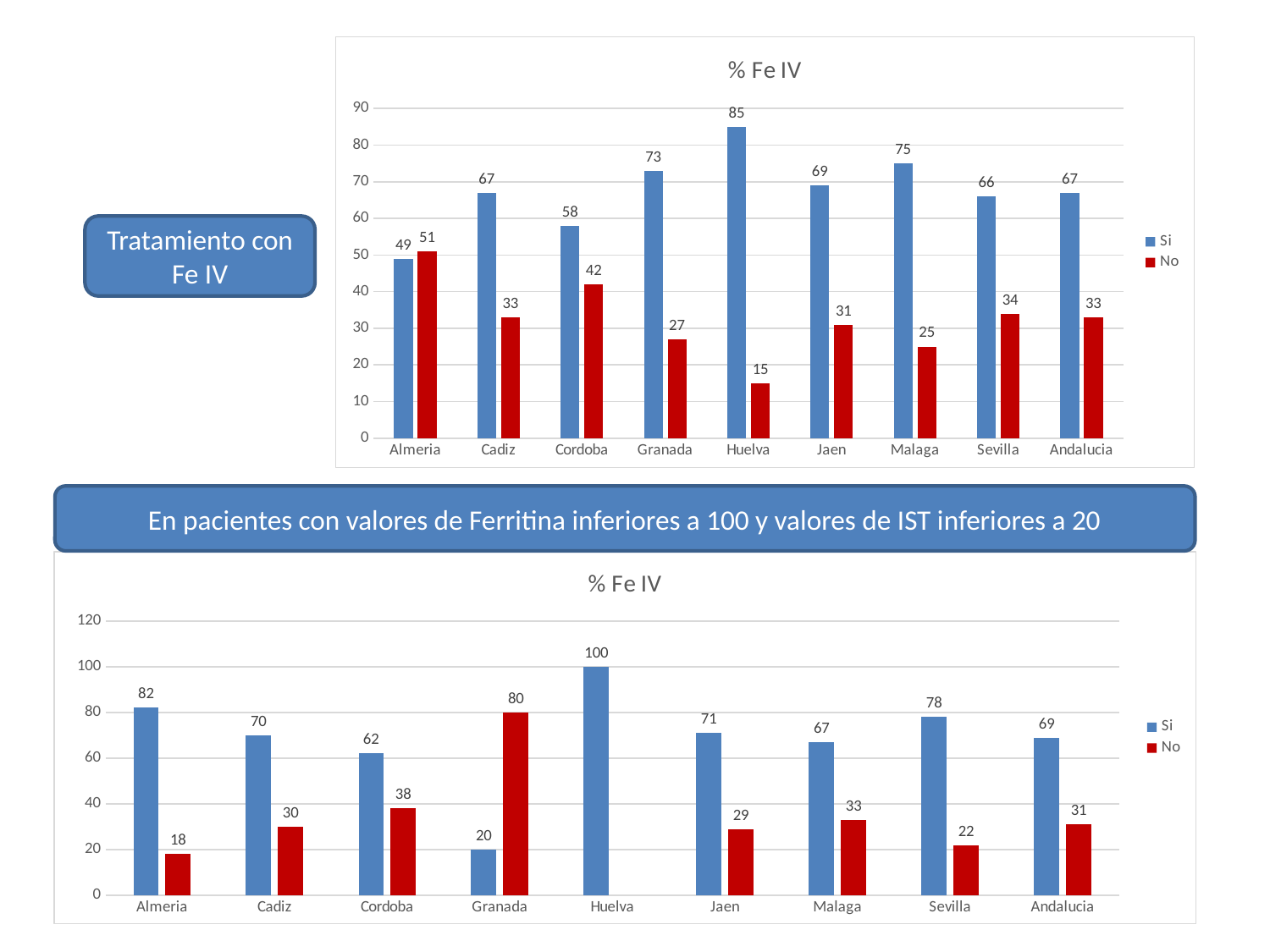
In the top chart, what is the difference between the 'Si' and 'No' values for Malaga? 50 In the bottom chart, what is the 'No' value for Granada? 80 In the top chart, which category has the highest 'Si' value? Huelva In the top chart, what is the 'Si' value for Huelva? 85 How many series does the legend of the top chart list? 2 In the top chart, which is larger for Almeria, the 'Si' value or the 'No' value? No In the top chart, which category has the lowest 'No' value? Huelva In the bottom chart, what is the difference between the 'Si' values for Almeria and Cadiz? 12 How many categories are shown on the x axis of the bottom chart? 9 In the bottom chart, what is the 'Si' value for Huelva? 100 In the bottom chart, which category has the lowest 'Si' value? Granada In the top chart, what is the 'No' value for Cordoba? 42